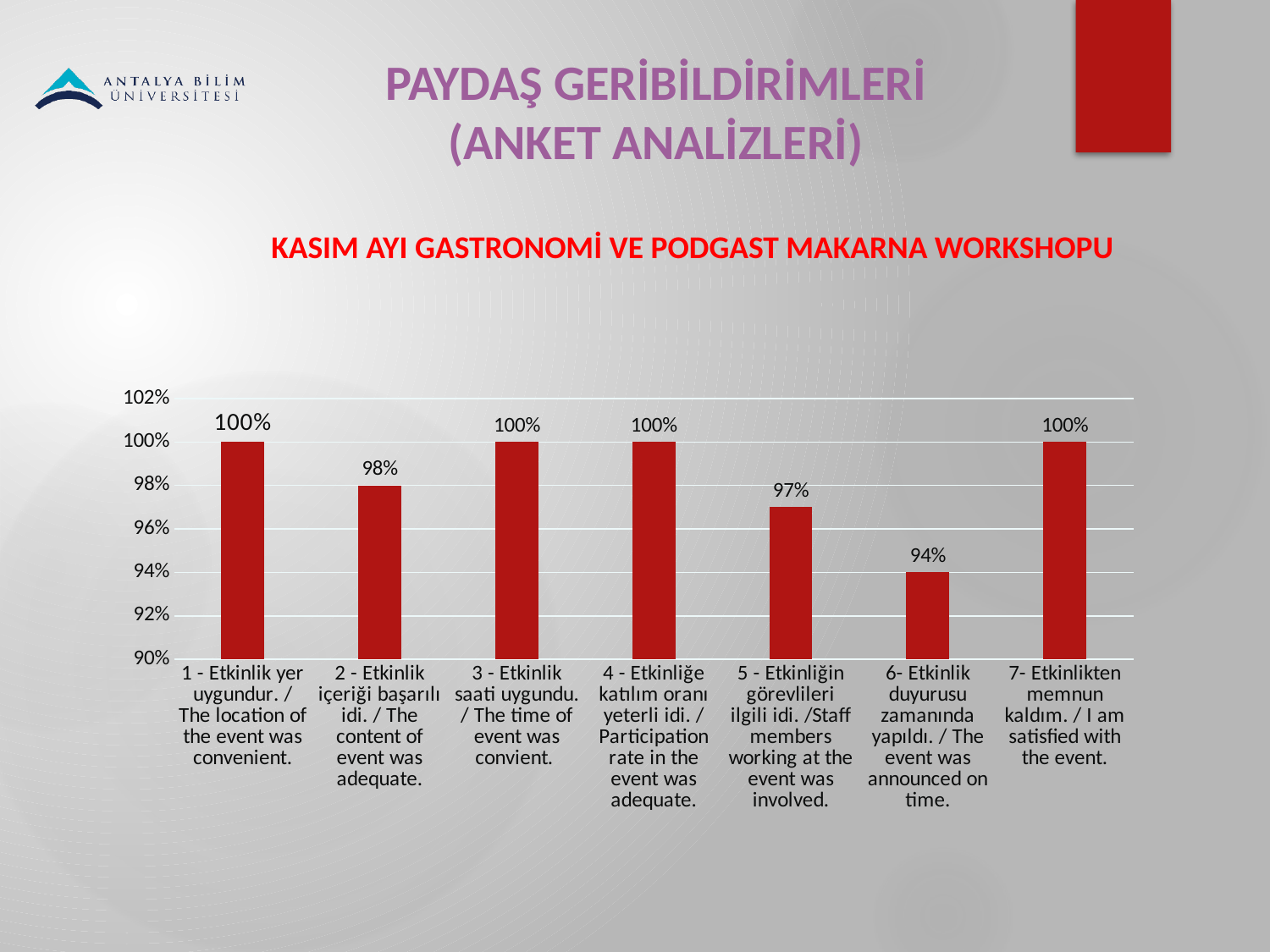
Which category has the lowest value? 6- Etkinlik duyurusu zamanında yapıldı. / The event was announced on time. What is the value for item 5 (Staff members working at the event was involved)? 97% Which is larger: the value for item 5 (Staff members working at the event was involved) or item 6 (The event was announced on time)? Item 5 (Staff members working at the event was involved) What kind of chart is shown on the slide? Bar chart What is the red subtitle above the chart? KASIM AYI GASTRONOMİ VE PODGAST MAKARNA WORKSHOPU What is the value for item 2 (Etkinlik içeriği başarılı idi / The content of event was adequate)? 98% What is the value for item 6 (The event was announced on time)? 94% What is the difference between the value for item 2 (The content of event was adequate) and item 5 (Staff members working at the event was involved)? 1% What is the value for item 7 (I am satisfied with the event)? 100% How many categories are shown on the chart? 7 What is the difference between the value for item 1 (The location of the event was convenient) and item 6 (The event was announced on time)? 6% How many categories have a value of 100%? 4